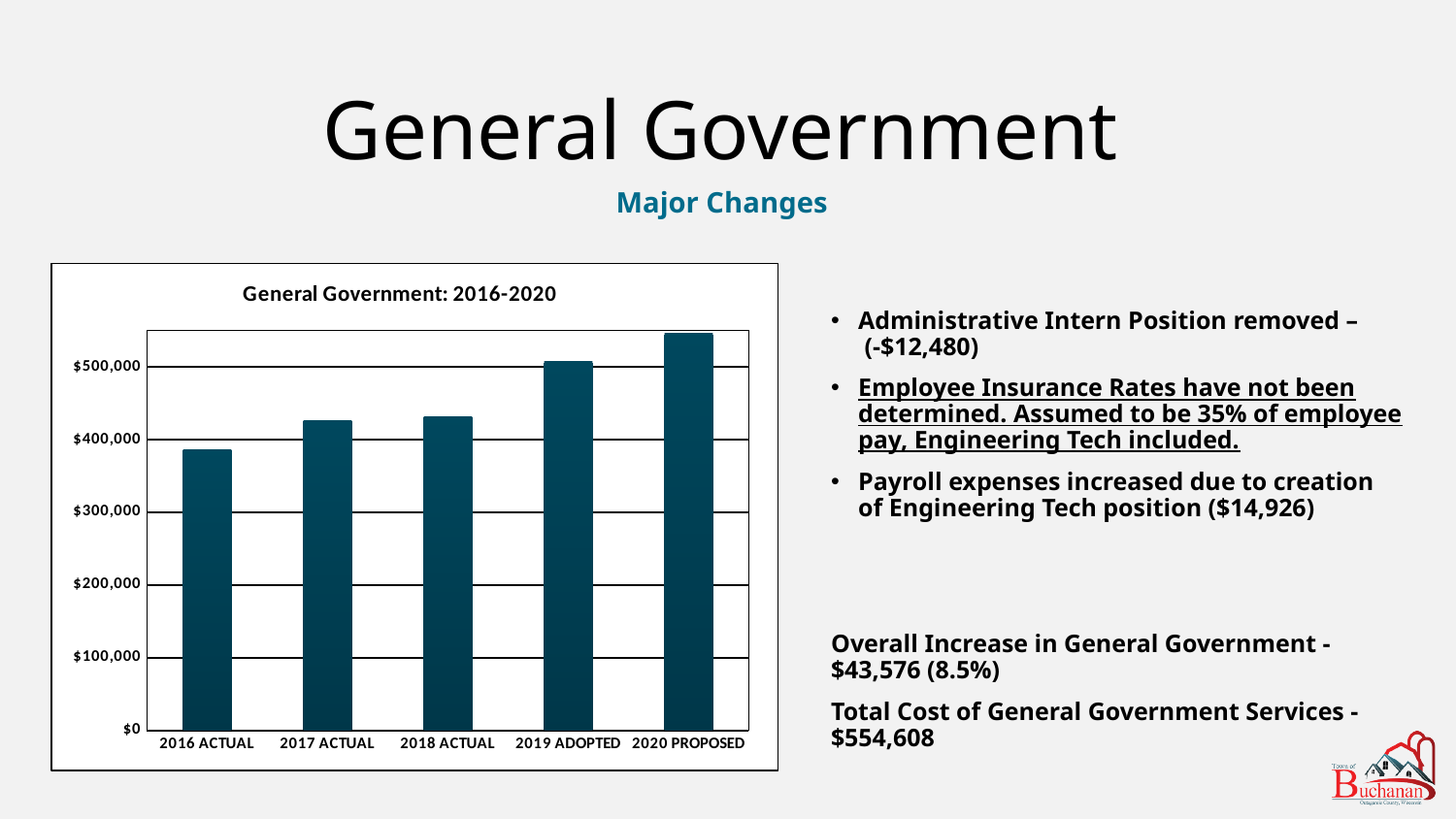
Is the value for 2019 ADOPTED greater or less than $400,000? greater Which is larger, the value for 2019 ADOPTED or 2020 PROPOSED? 2020 PROPOSED Do the values generally rise or fall from 2016 ACTUAL to 2020 PROPOSED? rise What is the title of the chart? General Government: 2016-2020 Which category has the lowest value in the chart? 2016 ACTUAL Which category has the highest value in the chart? 2020 PROPOSED Is the value for 2020 PROPOSED greater or less than $500,000? greater Is the value for 2016 ACTUAL greater or less than $400,000? less What type of chart is shown on the slide? Bar chart Which is larger, the value for 2016 ACTUAL or 2017 ACTUAL? 2017 ACTUAL How many categories are shown on the x axis of the chart? 5